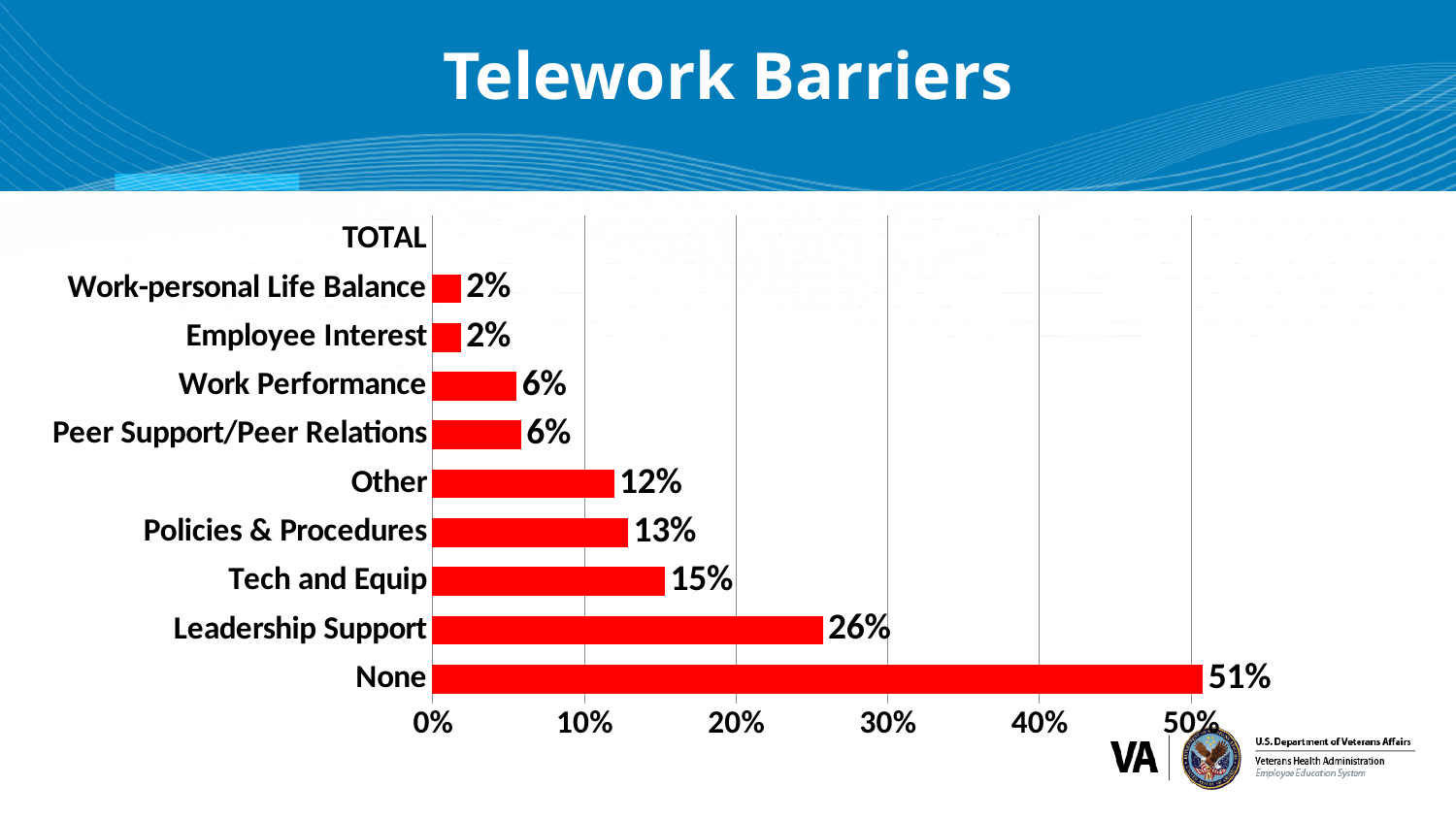
What is the difference between the values for None and Leadership Support? 25% Is the value for Leadership Support greater or less than 20%? greater Which category has the highest value? None What kind of chart is shown on the slide? Bar chart What is the value for Leadership Support? 26% Which is larger, the value for Other or the value for Tech and Equip? Tech and Equip What is the value for None? 51% What is the value for Policies & Procedures? 13% What is the title of the slide? Telework Barriers What is the value for Tech and Equip? 15% How many categories have a value of 2%? 2 What colour are the bars in the chart? Red